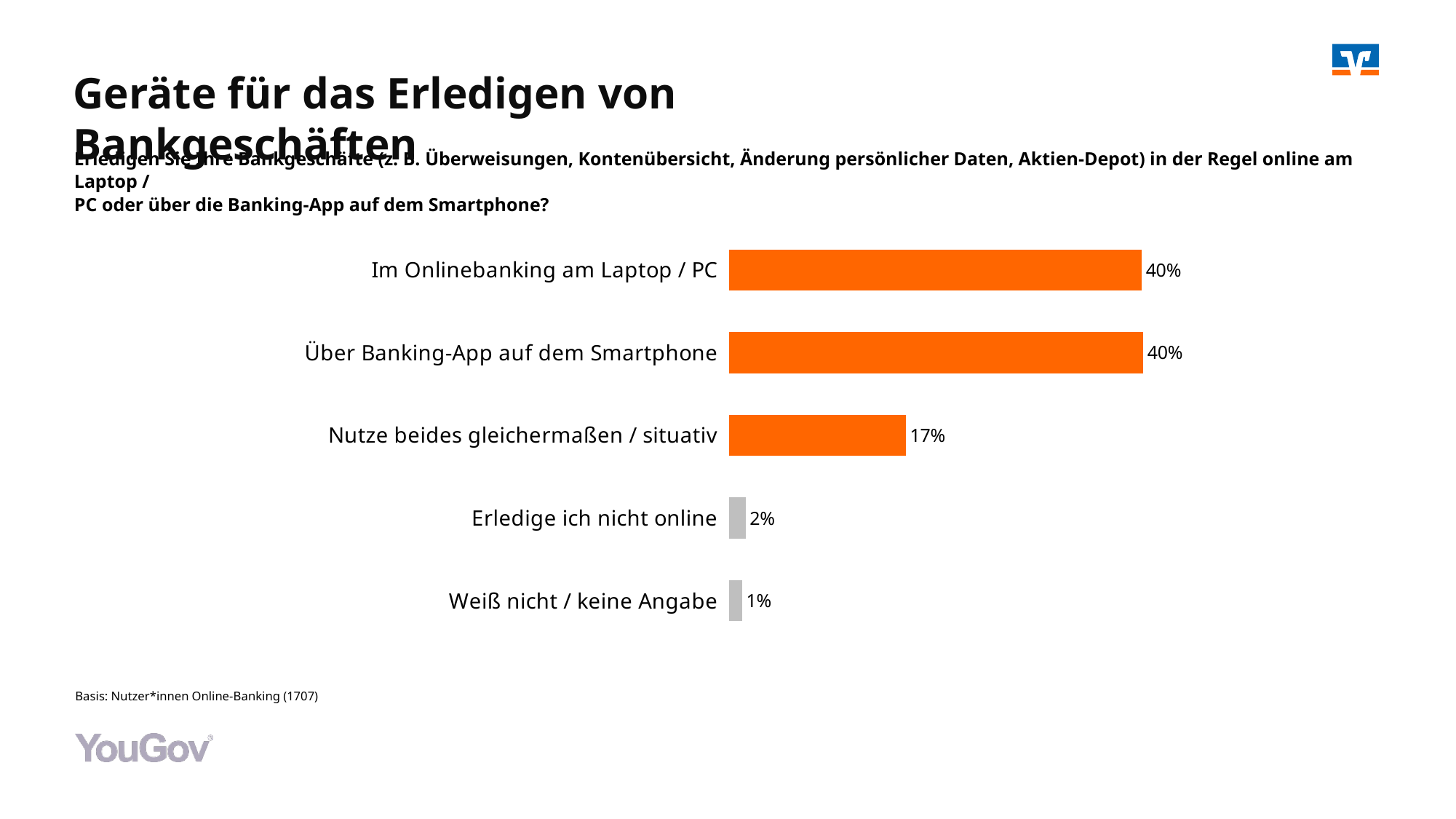
What is the value for "Weiß nicht / keine Angabe"? 1% What is the value for "Erledige ich nicht online"? 2% How many categories are shown in the chart? 5 What is the value for "Über Banking-App auf dem Smartphone"? 40% Which category has the lowest value in the chart? Weiß nicht / keine Angabe What percentage of respondents do their banking via online banking on a laptop / PC? 40% What is the difference between the value for "Erledige ich nicht online" and "Weiß nicht / keine Angabe"? 1 percentage point What percentage of respondents use both equally / situationally ("Nutze beides gleichermaßen / situativ")? 17% Which is larger: the value for "Nutze beides gleichermaßen / situativ" or for "Erledige ich nicht online"? Nutze beides gleichermaßen / situativ What is the difference between the value for "Über Banking-App auf dem Smartphone" and "Nutze beides gleichermaßen / situativ"? 23 percentage points What kind of chart is shown on the slide? Bar chart What colour are the bars for the two categories with the highest values? Orange